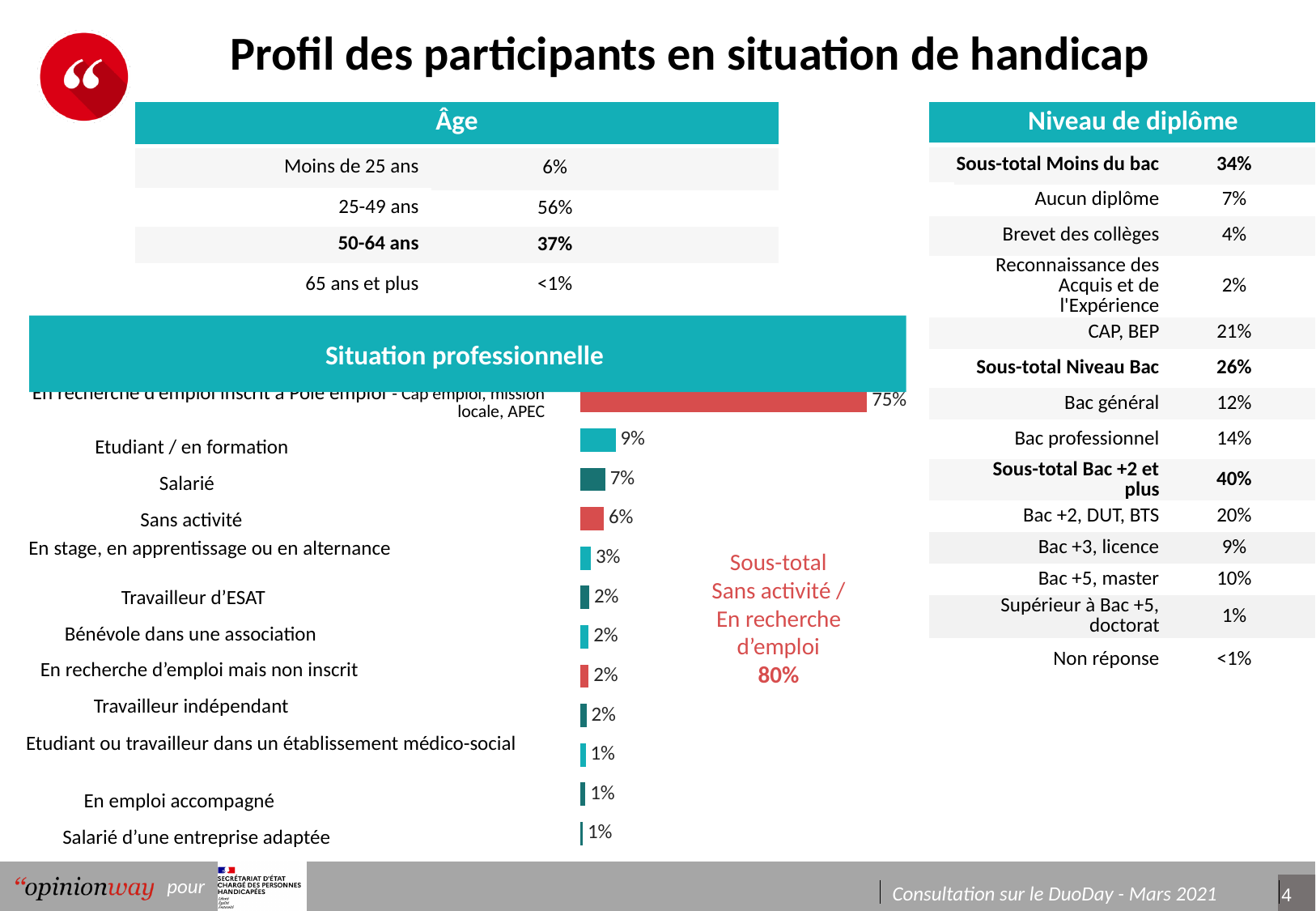
In the Situation professionnelle chart, which is larger: 'Sans activité' or 'Salarié'? Salarié What is the difference between the highest value and the value for 'Sans activité' in the Situation professionnelle chart? 69% What is the value for 'En stage, en apprentissage ou en alternance' in the Situation professionnelle chart? 3% What is the difference between the values for 'Etudiant / en formation' and 'Salarié' in the Situation professionnelle chart? 2% What is the value for 'Etudiant / en formation' in the Situation professionnelle chart? 9% What is the value for 'Travailleur indépendant' in the Situation professionnelle chart? 2% Which category has the highest value in the Situation professionnelle chart? En recherche d'emploi inscrit à Pôle emploi - Cap emploi, mission locale, APEC What is the value for 'Salarié' in the Situation professionnelle chart? 7% What kind of chart is the Situation professionnelle chart? Bar chart What sub-total percentage is annotated for 'Sans activité / En recherche d'emploi' in the Situation professionnelle chart? 80% What is the value for 'Sans activité' in the Situation professionnelle chart? 6% How many categories are shown in the Situation professionnelle chart? 12